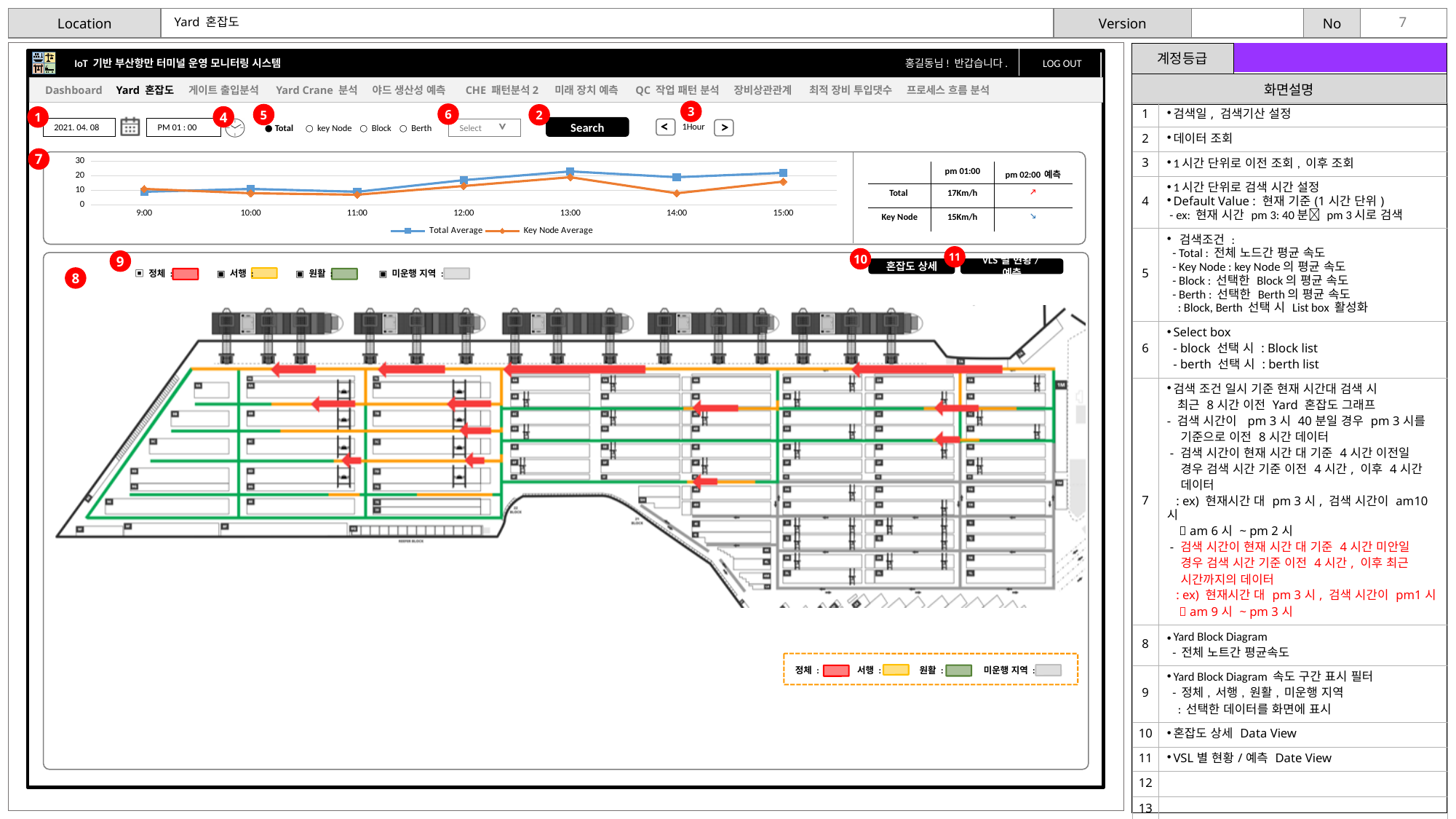
Is the Key Node Average value at 14:00 greater or less than 10? less How many series does the legend of the line chart list? 2 What are the two series named in the line chart's legend? Total Average and Key Node Average At which time does the Key Node Average series reach its highest value? 13:00 Is the Total Average value at 13:00 greater or less than 20? greater How many time points are plotted along the x axis of the line chart? 7 Does the Key Node Average series rise or fall between 13:00 and 14:00? fall Does the Total Average series rise or fall between 11:00 and 13:00? rise Is the Key Node Average value at 11:00 greater or less than 10? less At 14:00, which series has the larger value, Total Average or Key Node Average? Total Average What kind of chart is shown at the top of the screen mock-up? line chart